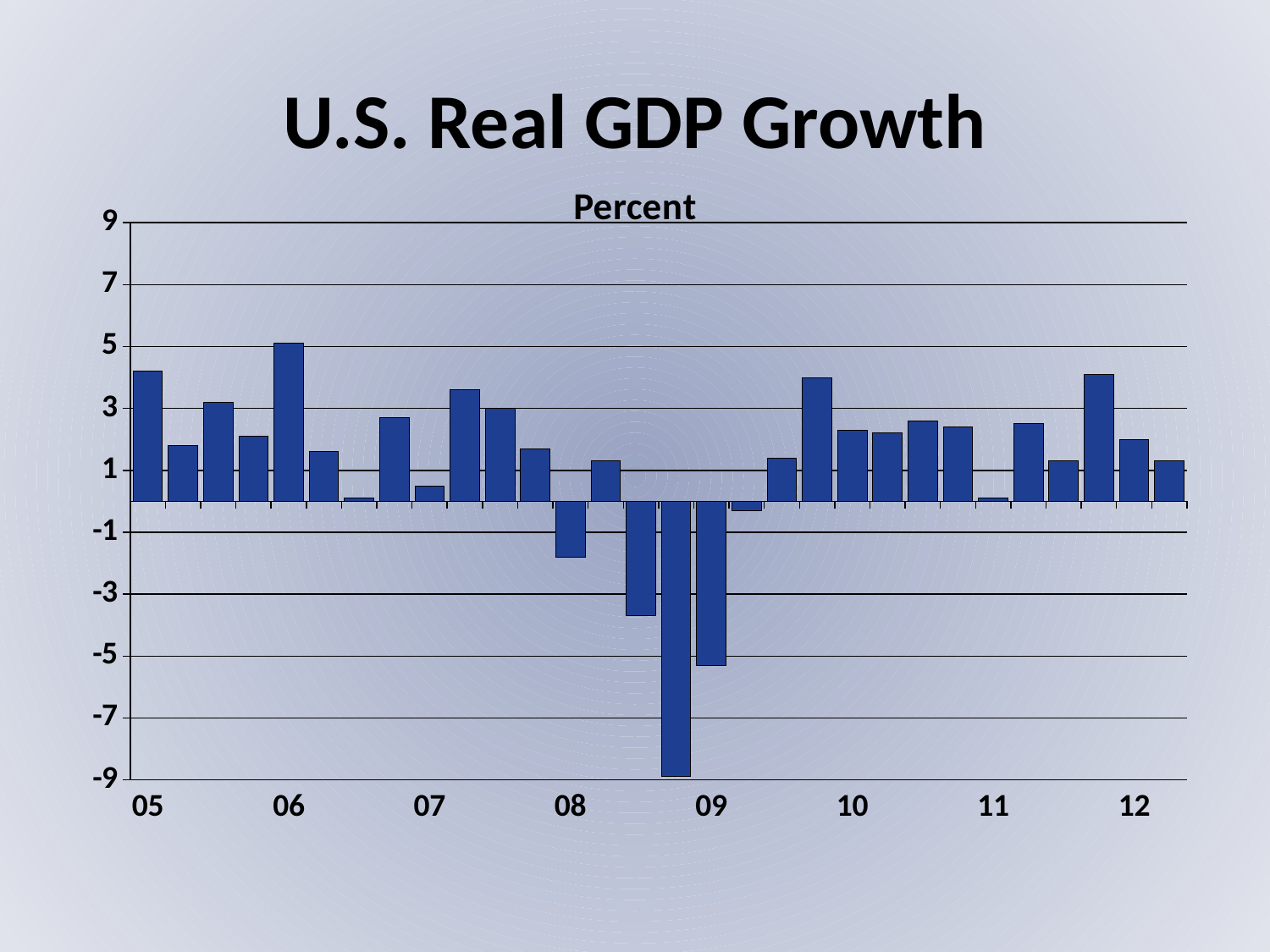
How many year labels are shown on the x axis? 8 What is the highest value shown on the vertical axis? 9 Is the value of the first bar (at 05) greater or less than 3? greater Is the value of the tallest bar greater or less than 3? greater What is the title of the chart? U.S. Real GDP Growth Is the value of the lowest bar greater or less than -7? less How many bars extend below -3 on the chart? 3 In which year does the tallest bar on the chart appear? 06 Which is larger: the tallest bar in 05 or the tallest bar in 06? 06 What kind of chart is shown on the slide? bar chart What unit label is shown above the chart's vertical axis? Percent